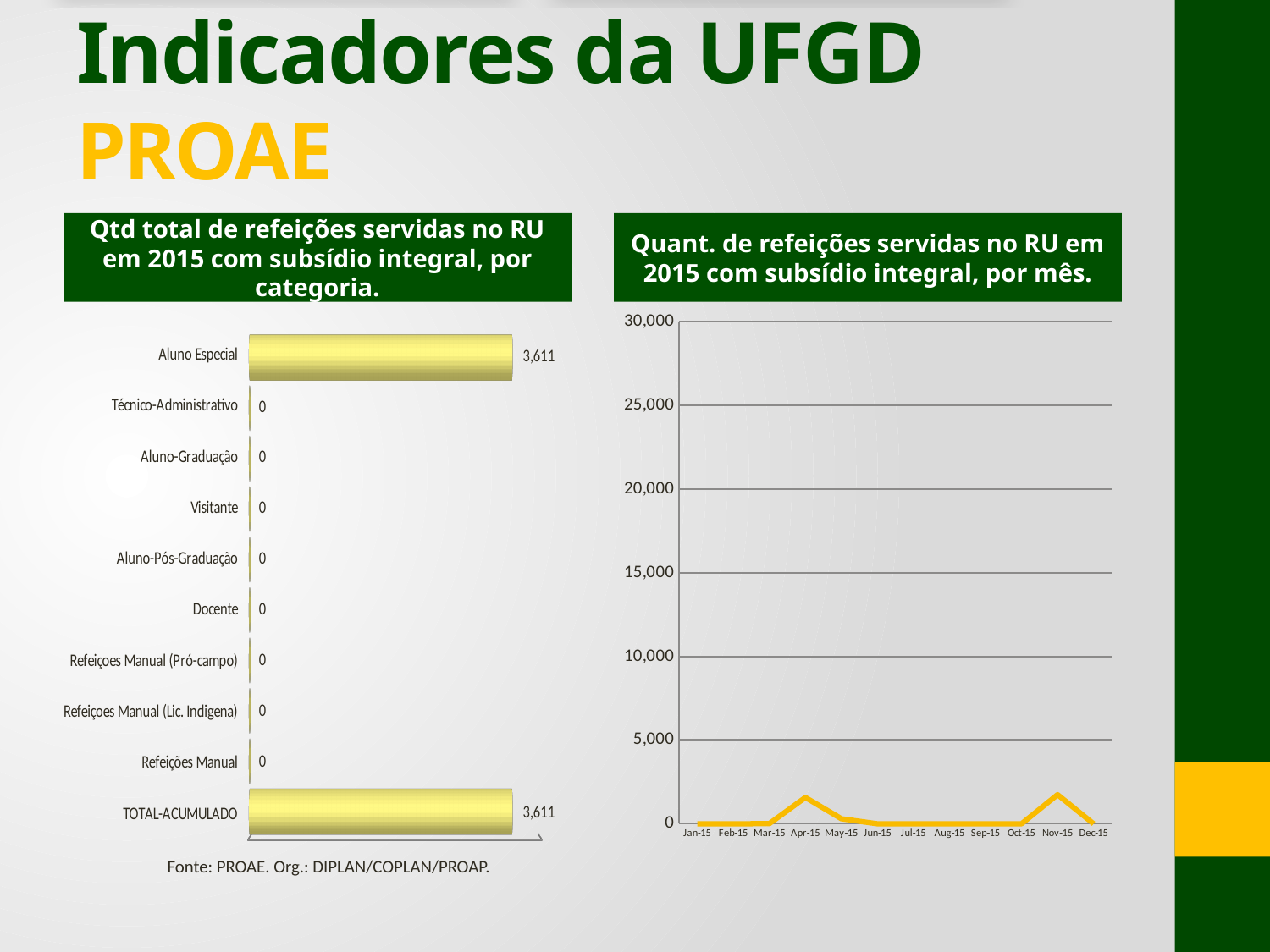
What source is cited below the left chart? Fonte: PROAE. Org.: DIPLAN/COPLAN/PROAP. What kind of chart is the right chart (Quant. de refeições servidas no RU em 2015 com subsídio integral, por mês)? line chart In the left chart (por categoria), what is the value for TOTAL-ACUMULADO? 3,611 In the left chart (Qtd total de refeições servidas no RU em 2015 com subsídio integral, por categoria), what is the value for Aluno Especial? 3,611 In the right chart (por mês), is the value for Apr-15 greater or less than 5,000? less In the right chart (por mês), is the value for Nov-15 greater or less than 5,000? less What kind of chart is the left chart (por categoria)? bar chart In the left chart (por categoria), how many categories are shown? 10 In the left chart (por categoria), what is the value for Docente? 0 In the left chart (por categoria), what is the difference between the value for Aluno Especial and the value for Técnico-Administrativo? 3,611 In the left chart (por categoria), which is larger, the value for Aluno Especial or the value for Visitante? Aluno Especial In the right chart (por mês), how many months are plotted on the x axis? 12